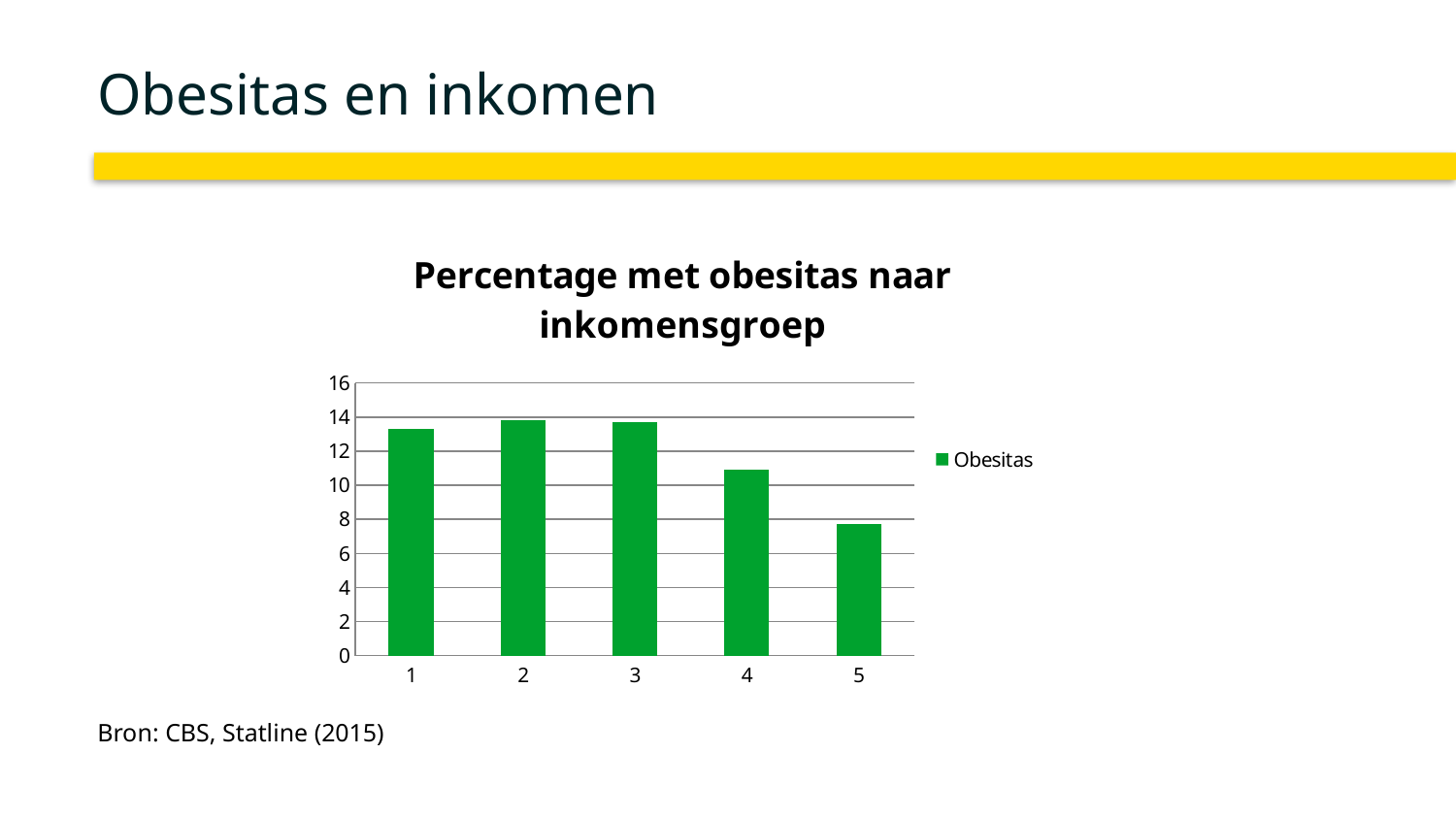
Which income group has the lowest obesity percentage? 5 Do the obesity percentages generally rise or fall from income group 1 to income group 5? fall Is the value for income group 1 greater or less than 12? greater How many series does the legend list? 1 What is the title of the chart? Percentage met obesitas naar inkomensgroep What kind of chart is shown on the slide? bar chart How many income groups (categories) are shown on the x axis? 5 Which is larger, the value for income group 1 or income group 4? income group 1 What series name is shown in the legend? Obesitas Is the value for income group 4 greater or less than 10? greater